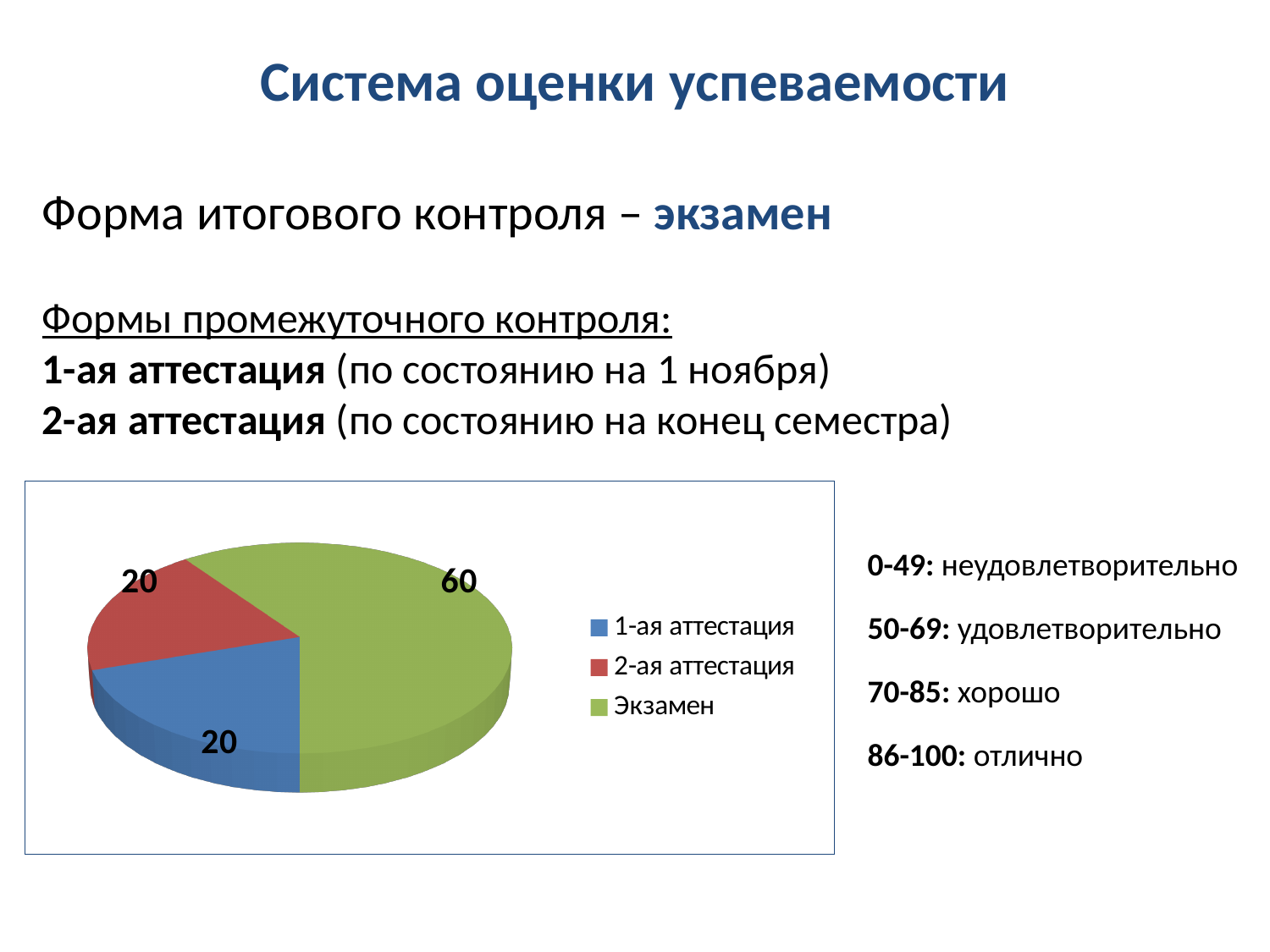
What kind of chart is shown on the slide? Pie chart Which is larger, the value for Экзамен or the value for 2-ая аттестация? Экзамен How many entries does the chart legend list? 3 What share of the pie does the Экзамен slice represent? 60% What value is shown for the 1-ая аттестация slice of the pie chart? 20 What value is shown for the Экзамен slice of the pie chart? 60 What colour is the Экзамен slice in the pie chart? Green Which category has the largest slice in the pie chart? Экзамен What is the difference between the values for Экзамен and 1-ая аттестация? 40 How many slices does the pie chart have? 3 What is the total of all the slice values in the pie chart? 100 What value is shown for the 2-ая аттестация slice of the pie chart? 20